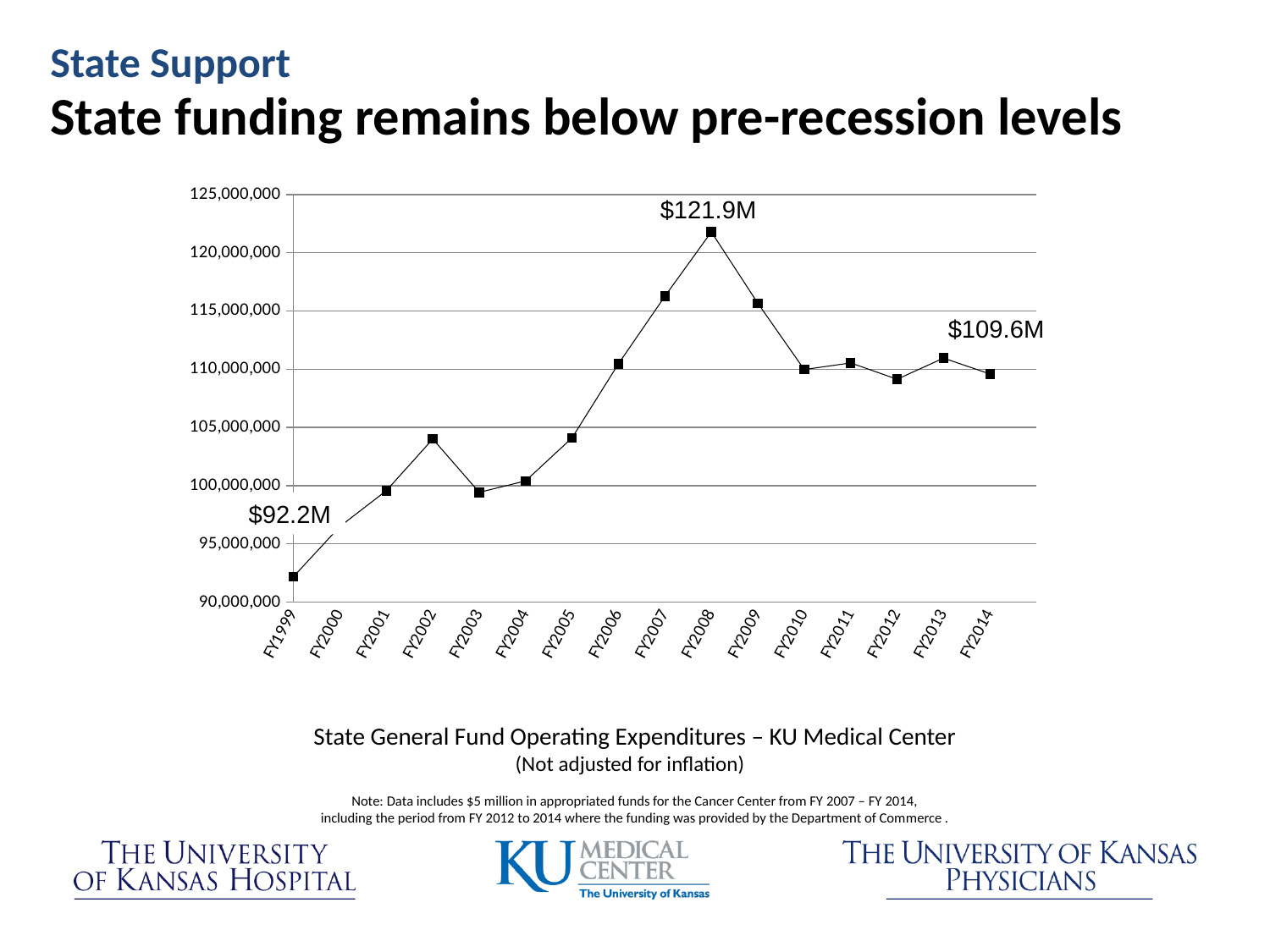
What is the value for FY1999? $92.2M How many fiscal years are plotted on the x axis? 16 Which fiscal year has the highest value? FY2008 Is the value for FY2005 greater or less than 100,000,000? greater What is the difference between the FY2008 value and the FY1999 value? $29.7M What is the value for FY2008? $121.9M Is the value for FY2007 greater or less than 115,000,000? greater What is the difference between the FY2008 value and the FY2014 value? $12.3M Which fiscal year has the lowest value? FY1999 What kind of chart is shown on the slide? Line chart Which is larger, the value for FY2001 or the value for FY2007? FY2007 What is the value for FY2014? $109.6M